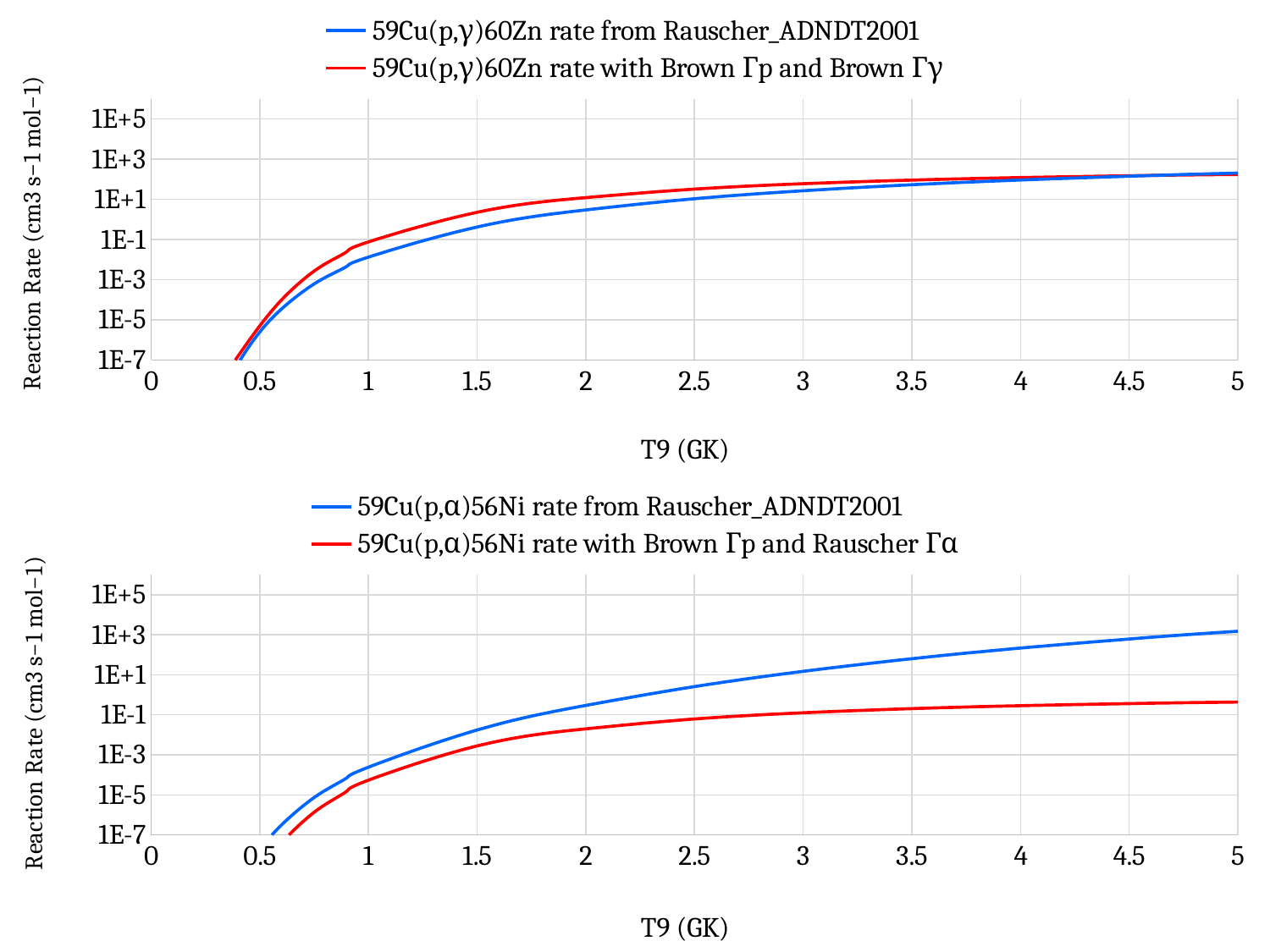
What is the x-axis label of the bottom chart? T9 (GK) In the bottom chart, at T9 = 5 GK, which series has the higher reaction rate: the Rauscher_ADNDT2001 rate or the rate with Brown Γp and Rauscher Γα? the Rauscher_ADNDT2001 rate In the bottom chart, is the 59Cu(p,α)56Ni rate with Brown Γp and Rauscher Γα at T9 = 5 GK greater or less than 1E+1? less What kind of chart is the top chart on the slide? line chart In the bottom chart, is the 59Cu(p,α)56Ni rate from Rauscher_ADNDT2001 at T9 = 4 GK greater or less than 1E+1? greater In the top chart, do the reaction rates rise or fall as T9 increases? rise How many series does the legend of the bottom chart list? 2 In the bottom chart, does the 59Cu(p,α)56Ni rate from Rauscher_ADNDT2001 rise or fall as T9 increases? rise How many series does the legend of the top chart list? 2 In the top chart, is the 59Cu(p,γ)60Zn rate from Rauscher_ADNDT2001 at T9 = 1 GK greater or less than 1E-1? less In the top chart, at T9 = 1 GK, which series has the higher reaction rate: the Rauscher_ADNDT2001 rate or the rate with Brown Γp and Brown Γγ? the rate with Brown Γp and Brown Γγ